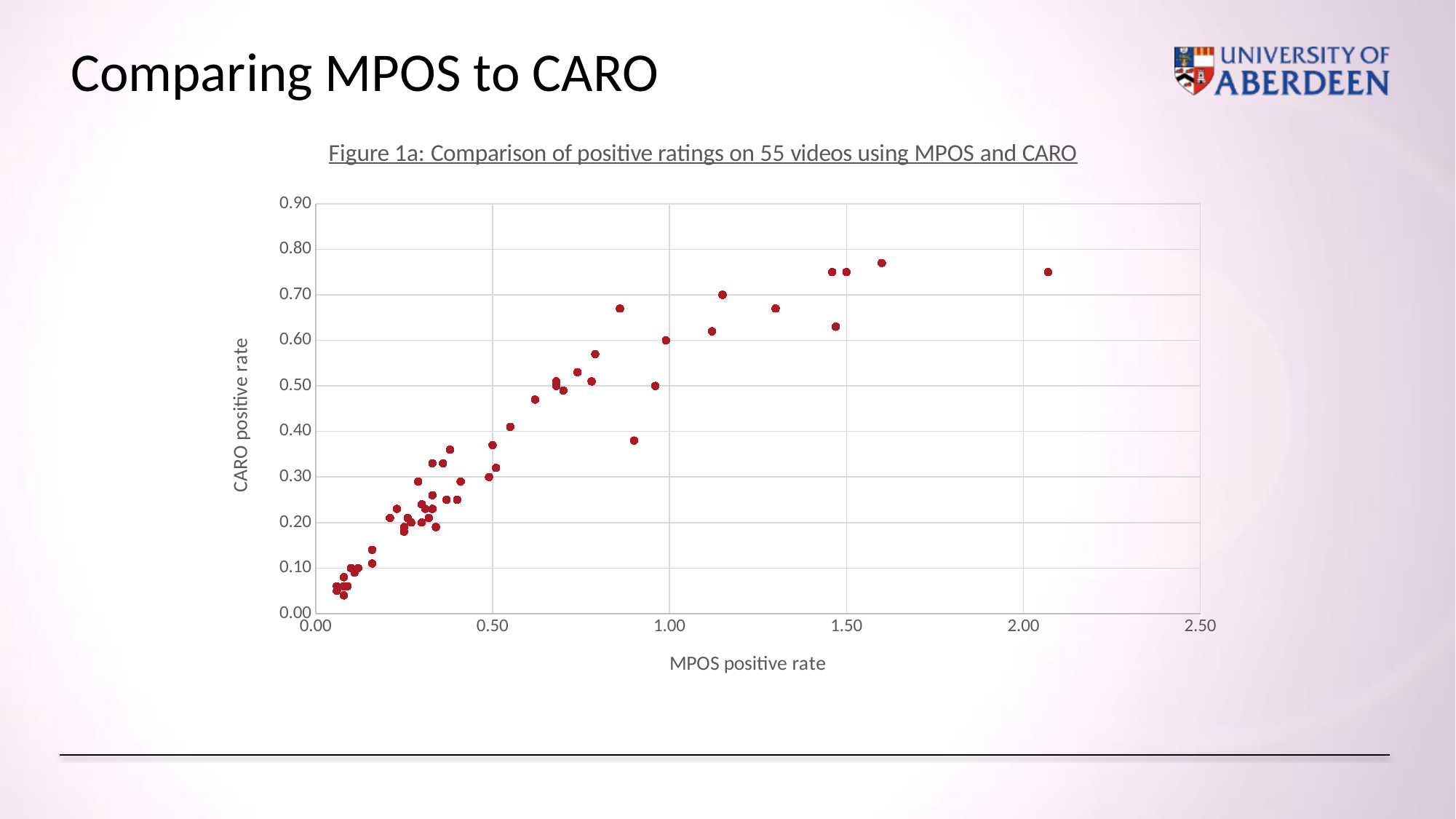
Is the MPOS positive rate of the rightmost point greater or less than 2.00? greater What kind of chart is shown on the slide? Scatter plot What is the title of the chart? Figure 1a: Comparison of positive ratings on 55 videos using MPOS and CARO Is the CARO positive rate of the rightmost point greater or less than 0.70? greater How many videos are plotted in the chart, according to its title? 55 Is the highest CARO positive rate plotted greater or less than 0.80? less What is the label of the x axis? MPOS positive rate As the MPOS positive rate increases along the x axis, does the CARO positive rate generally rise or fall? Rise Which is larger: the CARO positive rate of the rightmost point or the CARO positive rate of the leftmost point? The rightmost point